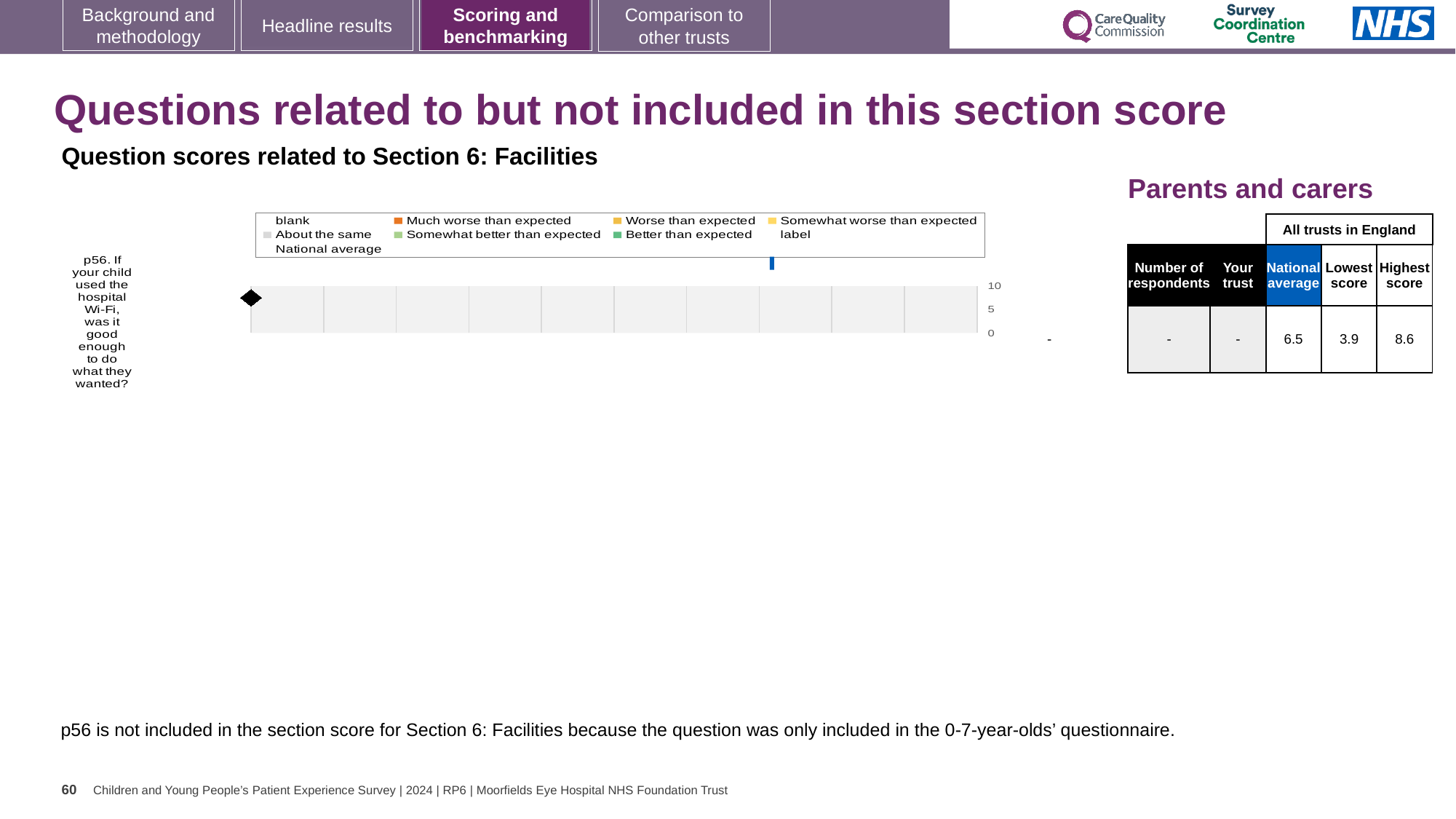
In the Parents and carers table, what is the highest score among all trusts in England for p56? 8.6 Which question number is plotted on the chart? p56 What is the difference between the highest score (8.6) and the lowest score (3.9) for p56? 4.7 In the Parents and carers table, what is the 'Your trust' score for p56? - How many entries does the chart's legend list? 9 In the Parents and carers table, what is the lowest score among all trusts in England for p56? 3.9 What is the highest tick value shown on the chart's score axis? 10 Which is larger for p56: the national average or the lowest score? national average Is the national average score for p56 greater or less than 5? greater What kind of chart is shown for the question scores related to Section 6: Facilities? bar chart In the Parents and carers table, what is the national average score for p56? 6.5 How many questions (categories) are plotted on the chart? 1